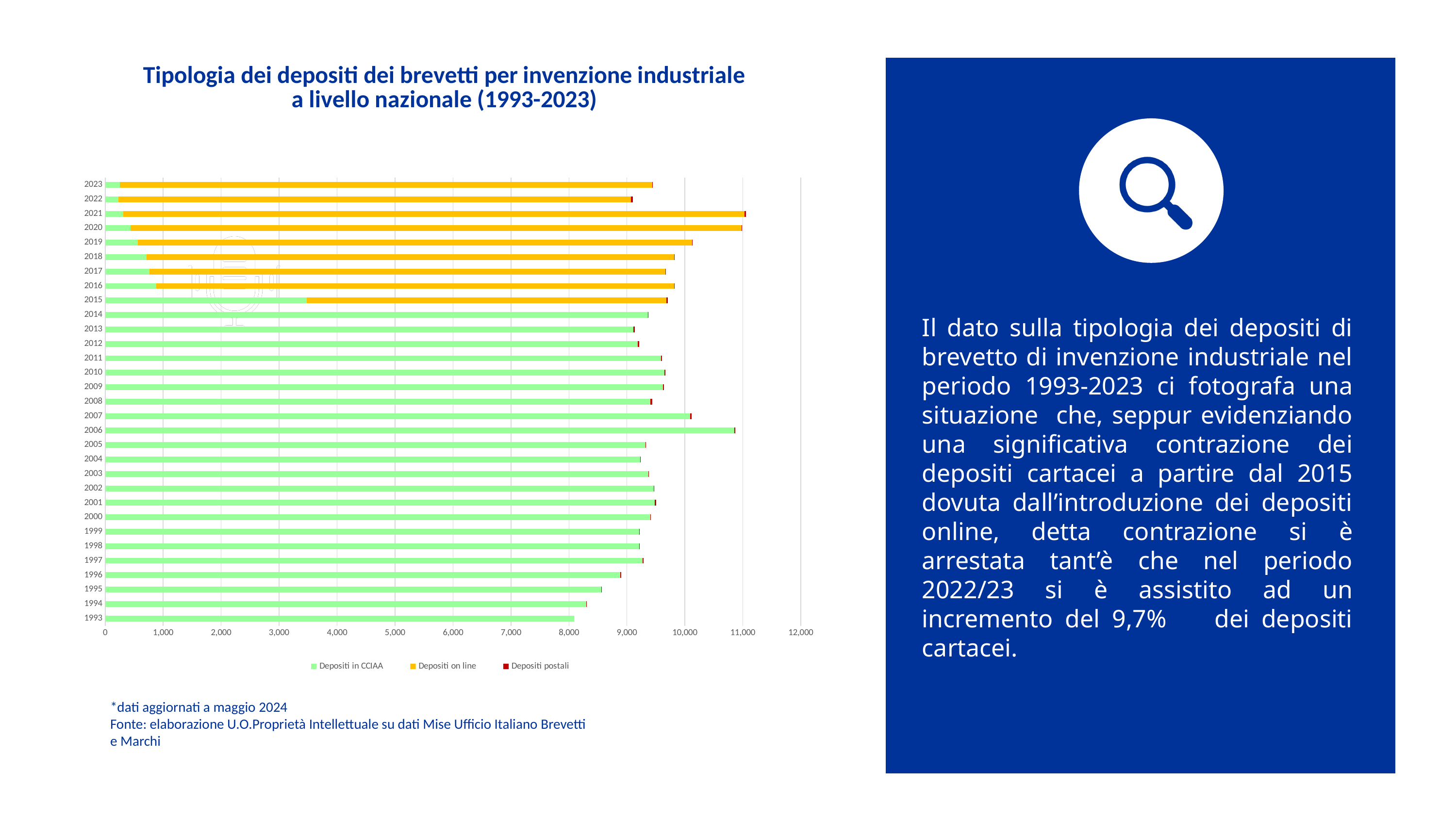
Which year has the shortest total bar? 1993 Is the Depositi in CCIAA value for 2017 greater or less than 1,000? less Which year has the larger total bar, 2006 or 2007? 2006 Which series is shown in orange in the legend? Depositi on line Which is the first year in which Depositi on line appear on the chart? 2015 How many series does the legend list? 3 Is the total value for 2006 greater or less than 10,000? greater What kind of chart is shown on the slide? Stacked bar chart Is the total value for 2023 greater or less than 9,000? greater Which year has the larger Depositi in CCIAA value, 2015 or 2016? 2015 How many years are plotted on the chart? 31